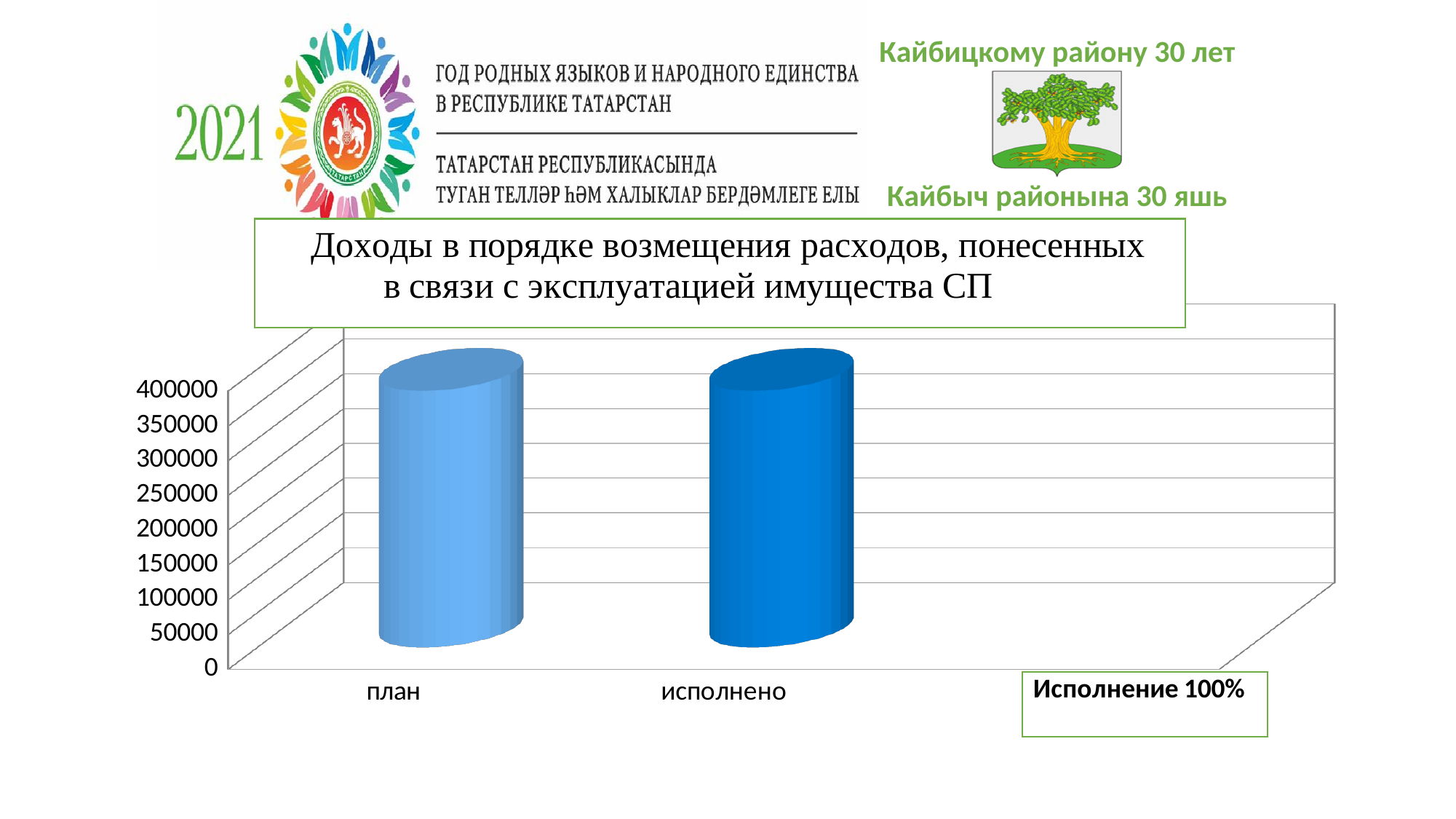
What execution percentage is stated in the box next to the chart? 100% How many categories are shown on the x axis of the chart? 2 What is the highest tick value shown on the vertical axis of the chart? 400000 Is the value for исполнено greater or less than 250000? greater What are the two categories shown on the x axis of the chart? план, исполнено What kind of chart is shown on the slide? bar chart Is the value for план greater or less than 300000? greater Is the value for план greater or less than 200000? greater